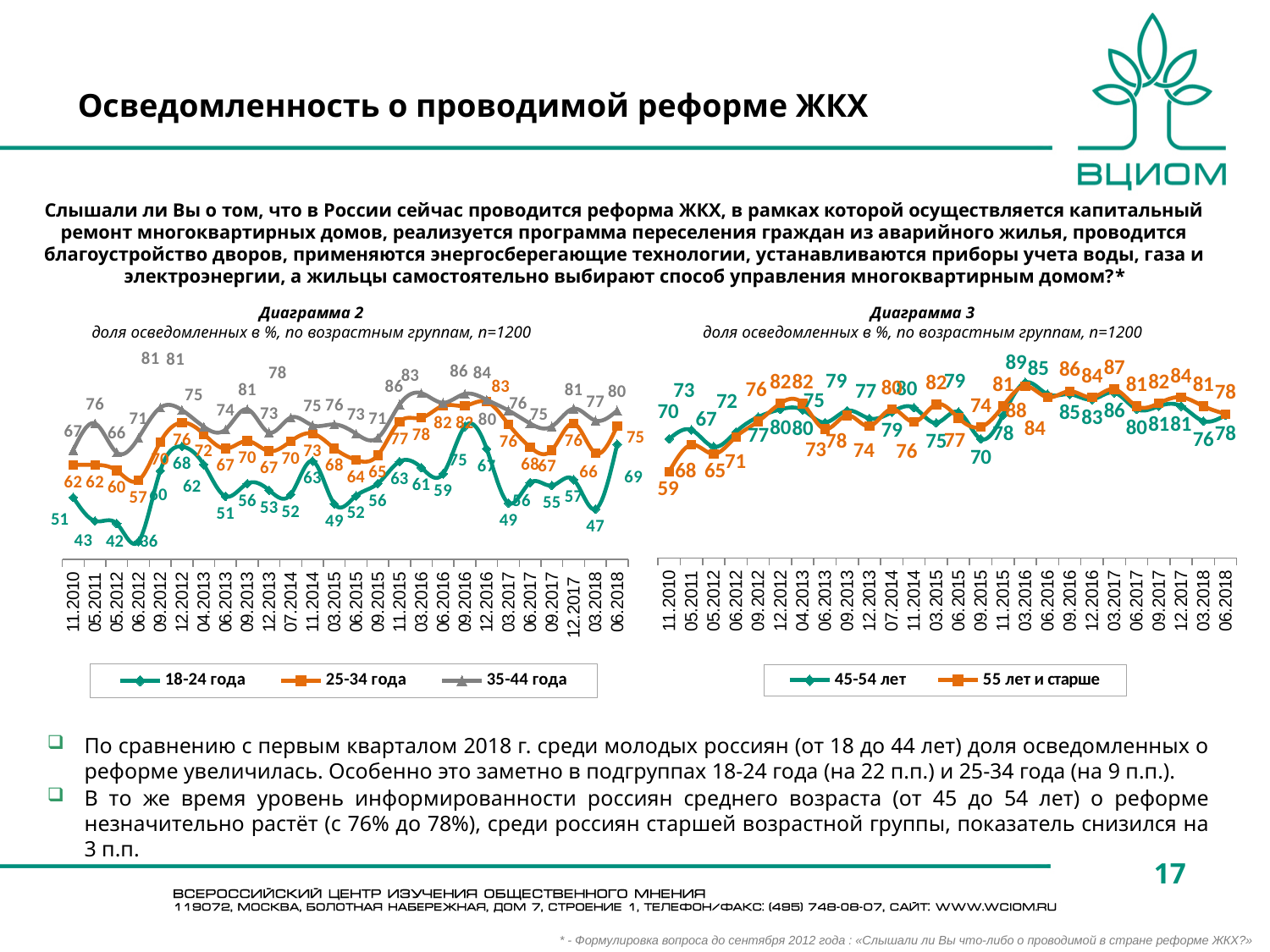
What kind of chart is Диаграмма 2? Line chart In Диаграмма 3, what is the value for the 55 лет и старше series at 11.2010? 59 In Диаграмма 2, what is the value for the 25-34 года series at 06.2018? 75 In Диаграмма 2, by how much did the 18-24 года series change between 03.2018 and 06.2018? 22 How many series does the legend of Диаграмма 2 list? 3 In Диаграмма 2, what is the lowest value of the 18-24 года series, and at which date? 36, 06.2012 How many series does the legend of Диаграмма 3 list? 2 In Диаграмма 2, what is the value for the 18-24 года series at 03.2018? 47 In Диаграмма 2, at 11.2010, which is larger: the 35-44 года series or the 18-24 года series? 35-44 года In Диаграмма 2, what is the value for the 18-24 года series at 06.2018? 69 In Диаграмма 3, what is the difference between the 45-54 лет and 55 лет и старше series at 11.2010? 11 In Диаграмма 3, what is the highest value of the 45-54 лет series? 89